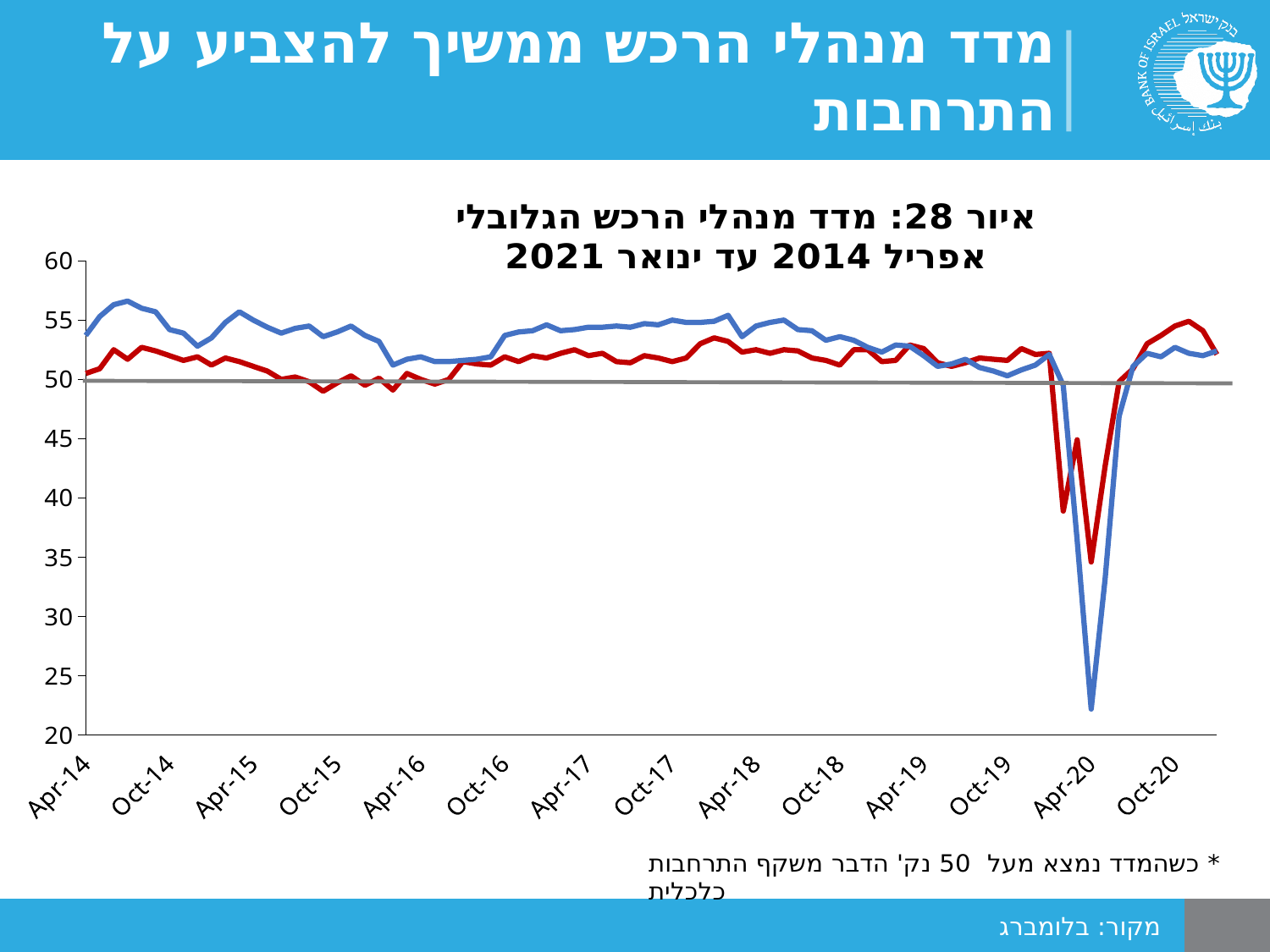
Is the value of the blue line at Oct-14 greater or less than 55? less Is the lowest point of the red line, reached around Apr-20, greater or less than 40? less How many coloured data lines (excluding the grey reference line) are plotted on the chart? 2 Is the value of the blue line at Apr-14 greater or less than 50? greater Which line drops to a lower minimum around Apr-20, the blue line or the red line? the blue line At what value is the horizontal grey reference line drawn? 50 How many date labels are shown on the x axis? 14 Do the lines rise or fall sharply between Oct-19 and Apr-20? fall What kind of chart is shown on the slide? line chart What is the highest value shown on the y axis? 60 What is the title of the chart? איור 28: מדד מנהלי הרכש הגלובלי אפריל 2014 עד ינואר 2021